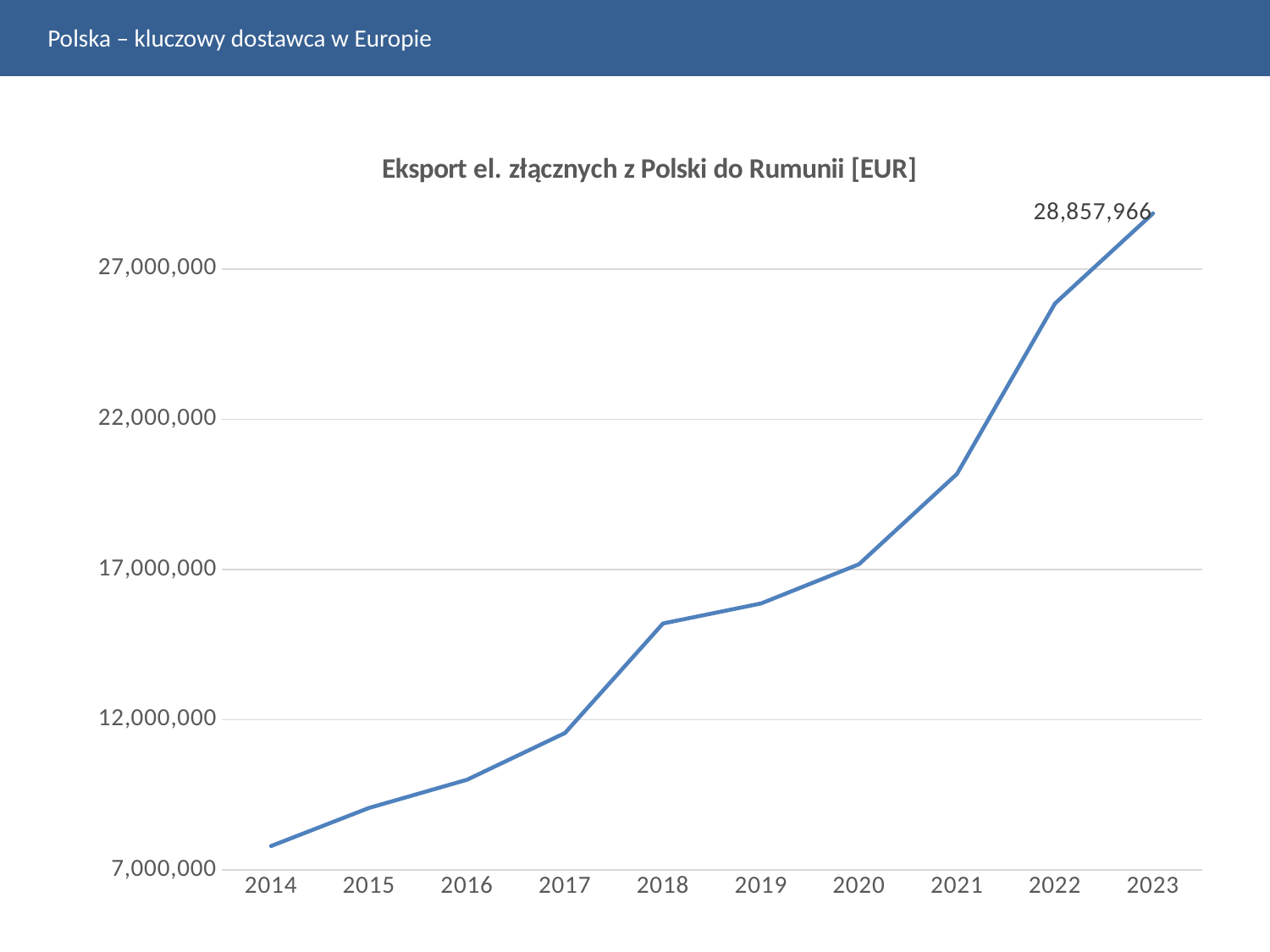
What kind of chart is shown on the slide? line chart Is the value for 2014 greater or less than 12,000,000? less Which year has the lowest value? 2014 Is the value for 2021 greater or less than 22,000,000? less Do the values rise or fall from 2014 to 2023? rise Is the value for 2018 greater or less than 12,000,000? greater Which year has the larger value, 2018 or 2022? 2022 What is the value for 2023? 28,857,966 How many years are plotted on the chart? 10 Which year has the highest value? 2023